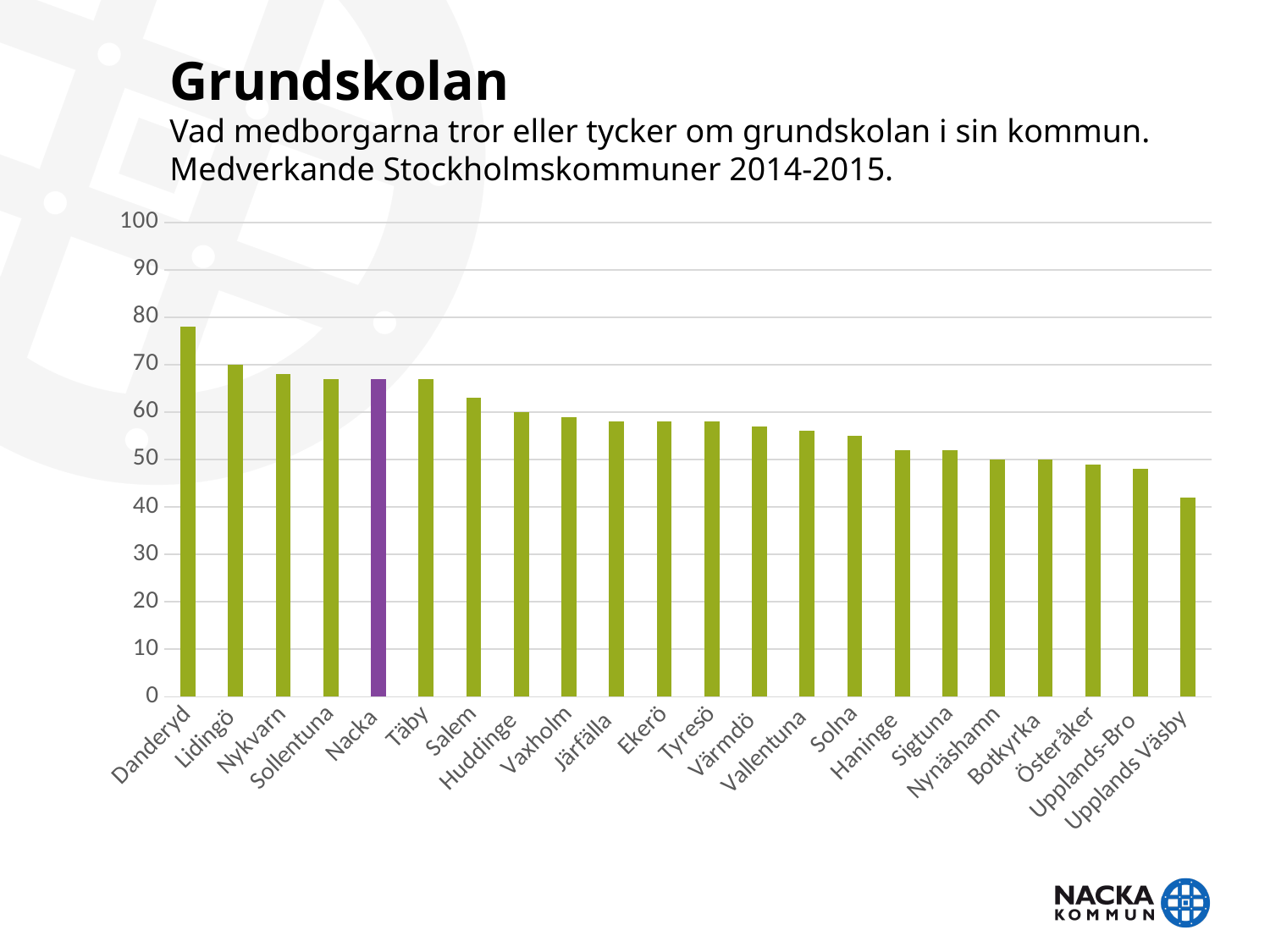
Is the value for Danderyd greater or less than 70? greater Which is larger, the value for Danderyd or the value for Solna? Danderyd Is the value for Nacka greater or less than 60? greater Which bar is shown in a different colour (purple) from the others? Nacka Which municipality has the lowest value in the chart? Upplands Väsby What is the title of the slide containing the chart? Grundskolan Is the value for Upplands Väsby greater or less than 50? less How many municipalities are shown on the x axis? 22 What kind of chart is shown on the slide? bar chart Do the values rise or fall from left to right along the x axis? fall Which municipality has the highest value in the chart? Danderyd